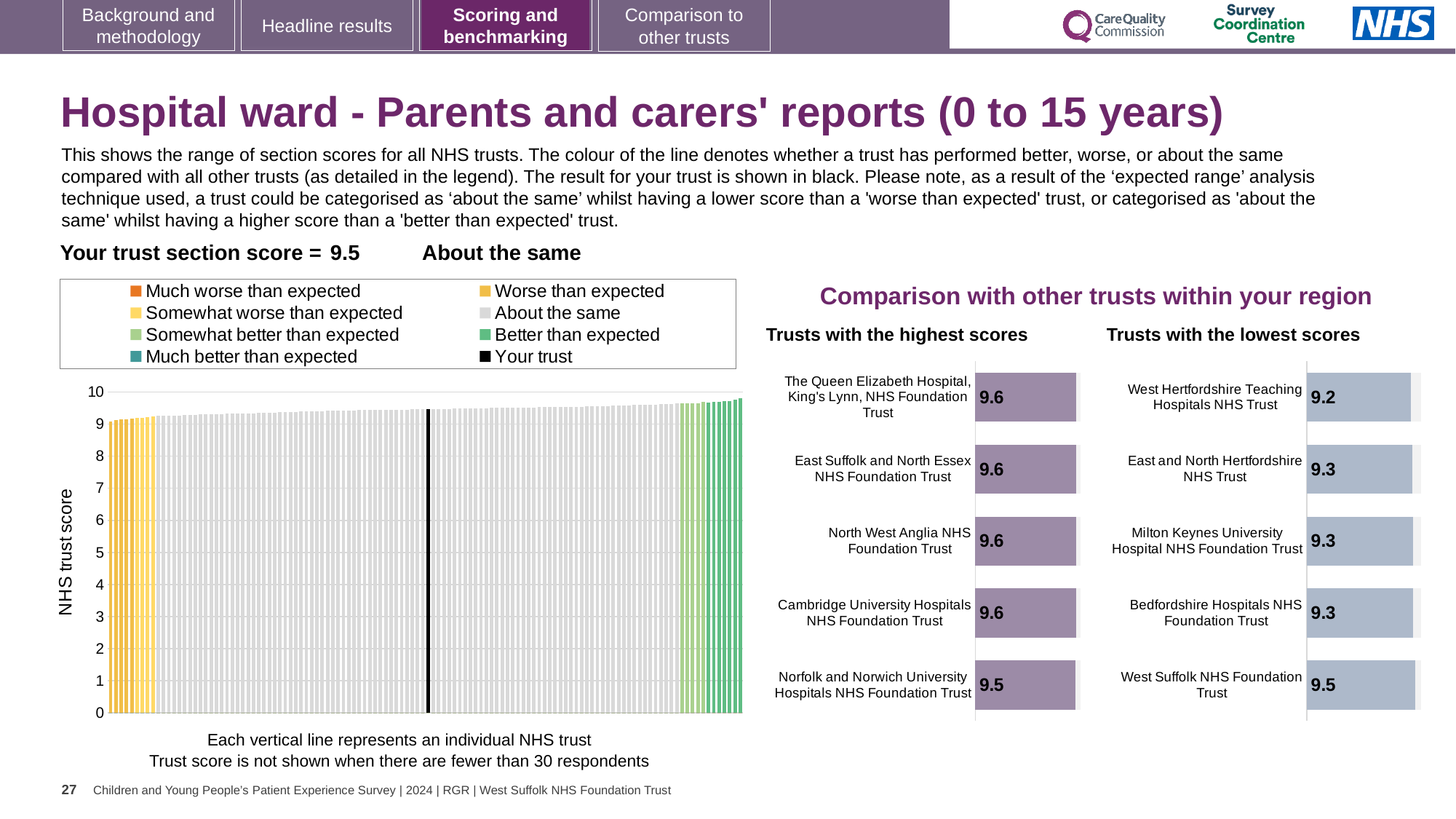
How many trusts are listed in the 'Trusts with the highest scores' chart? 5 In the 'Trusts with the lowest scores' chart, which trust has the highest score? West Suffolk NHS Foundation Trust In the 'Trusts with the lowest scores' chart, what is the difference between the scores of West Suffolk NHS Foundation Trust and West Hertfordshire Teaching Hospitals NHS Trust? 0.3 In the 'Trusts with the lowest scores' chart, what is the score for West Hertfordshire Teaching Hospitals NHS Trust? 9.2 In the 'Trusts with the highest scores' chart, what is the score for Norfolk and Norwich University Hospitals NHS Foundation Trust? 9.5 Which is larger: the score for The Queen Elizabeth Hospital, King's Lynn, NHS Foundation Trust in the highest scores chart, or the score for West Hertfordshire Teaching Hospitals NHS Trust in the lowest scores chart? The Queen Elizabeth Hospital, King's Lynn, NHS Foundation Trust How many entries does the legend of the main chart on the left list? 8 In the 'Trusts with the lowest scores' chart, which trust has the lowest score? West Hertfordshire Teaching Hospitals NHS Trust In the main chart on the left, is the value for the black 'Your trust' line greater or less than 8? greater In the main chart on the left, do the trust scores rise or fall from left to right along the x axis? Rise What kind of chart is the 'Trusts with the lowest scores' chart? Bar chart In the 'Trusts with the highest scores' chart, what is the score for Cambridge University Hospitals NHS Foundation Trust? 9.6